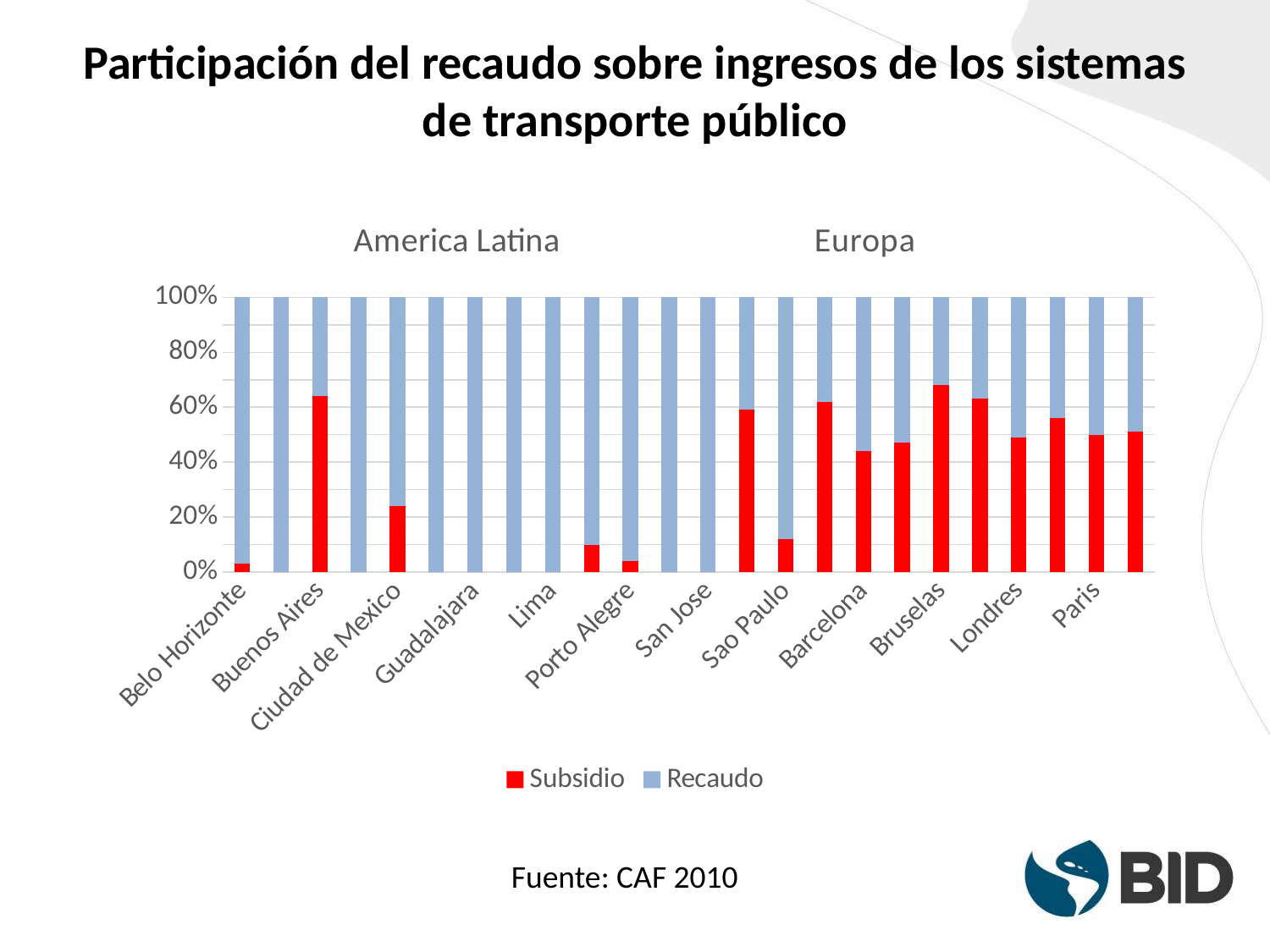
What is the total of the stacked bar for Buenos Aires? 100% Is the Subsidio value for Bruselas greater or less than 60%? greater Is the Subsidio value for Ciudad de Mexico greater or less than 20%? greater Is the Subsidio value for Belo Horizonte greater or less than 20%? less Which two series are listed in the legend? Subsidio and Recaudo Which has a larger Subsidio share, Bruselas or Porto Alegre? Bruselas Which has a larger Subsidio share, Buenos Aires or Ciudad de Mexico? Buenos Aires How many series does the legend list? 2 What are the two regional group labels shown above the chart? America Latina and Europa What kind of chart is shown on the slide? Stacked bar chart